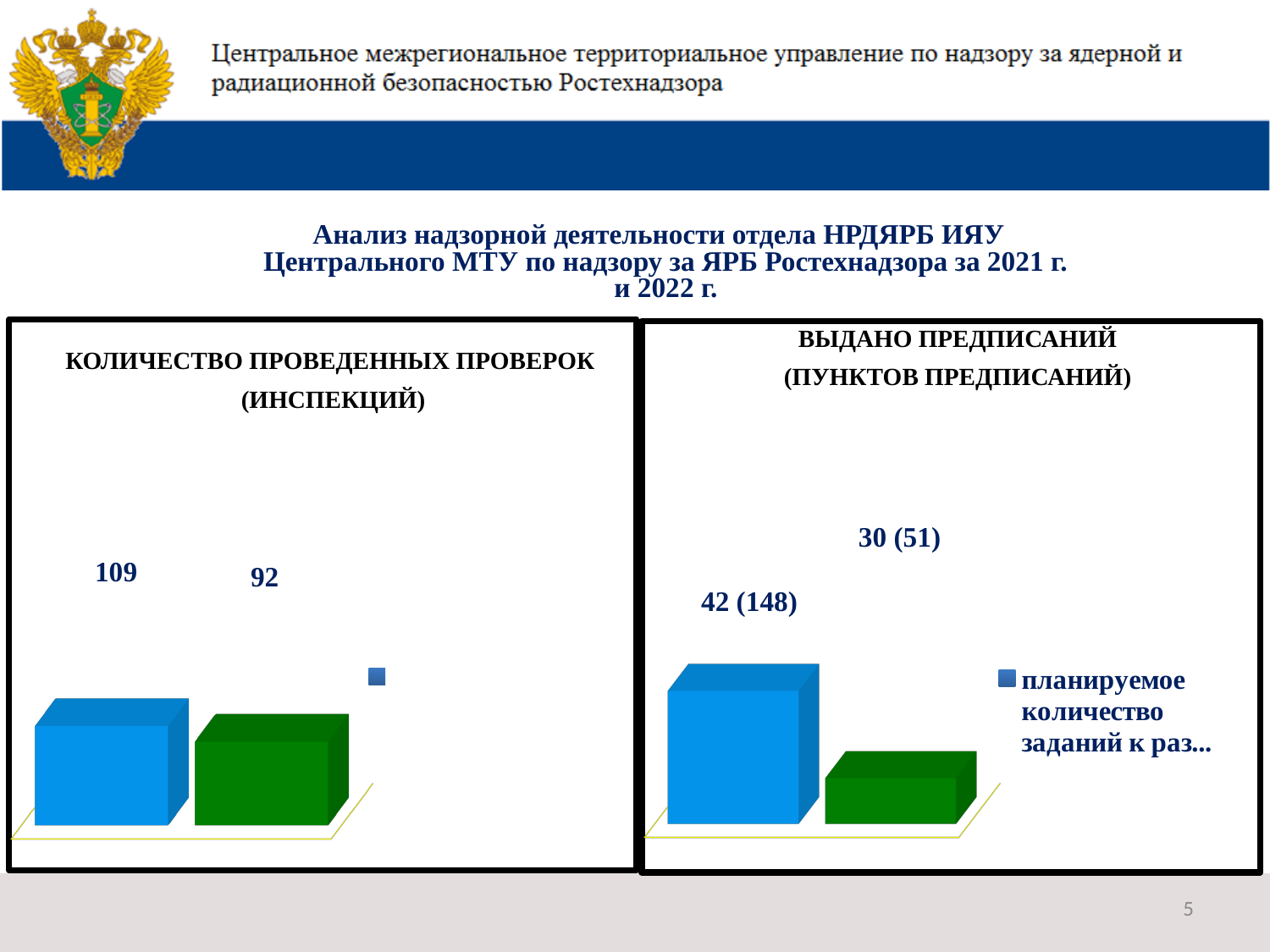
In the left chart (КОЛИЧЕСТВО ПРОВЕДЕННЫХ ПРОВЕРОК), what value is labelled on the blue bar? 109 In the left chart (КОЛИЧЕСТВО ПРОВЕДЕННЫХ ПРОВЕРОК), what value is labelled on the green bar? 92 What is the title of the right chart? ВЫДАНО ПРЕДПИСАНИЙ (ПУНКТОВ ПРЕДПИСАНИЙ) In the right chart (ВЫДАНО ПРЕДПИСАНИЙ), which bar is the lowest? the green bar How many bars are plotted in the left chart (КОЛИЧЕСТВО ПРОВЕДЕННЫХ ПРОВЕРОК)? 2 In the left chart (КОЛИЧЕСТВО ПРОВЕДЕННЫХ ПРОВЕРОК), what is the difference between the blue bar and the green bar? 17 How many bars are plotted in the right chart (ВЫДАНО ПРЕДПИСАНИЙ)? 2 What kind of chart is the left chart (КОЛИЧЕСТВО ПРОВЕДЕННЫХ ПРОВЕРОК)? bar chart In the right chart (ВЫДАНО ПРЕДПИСАНИЙ), what label is printed above the green bar? 30 (51) In the left chart (КОЛИЧЕСТВО ПРОВЕДЕННЫХ ПРОВЕРОК), which bar is taller, the blue one or the green one? the blue one In the right chart (ВЫДАНО ПРЕДПИСАНИЙ), what is the difference between the first numbers on the blue bar (42) and the green bar (30)? 12 In the right chart (ВЫДАНО ПРЕДПИСАНИЙ), what label is printed above the blue bar? 42 (148)